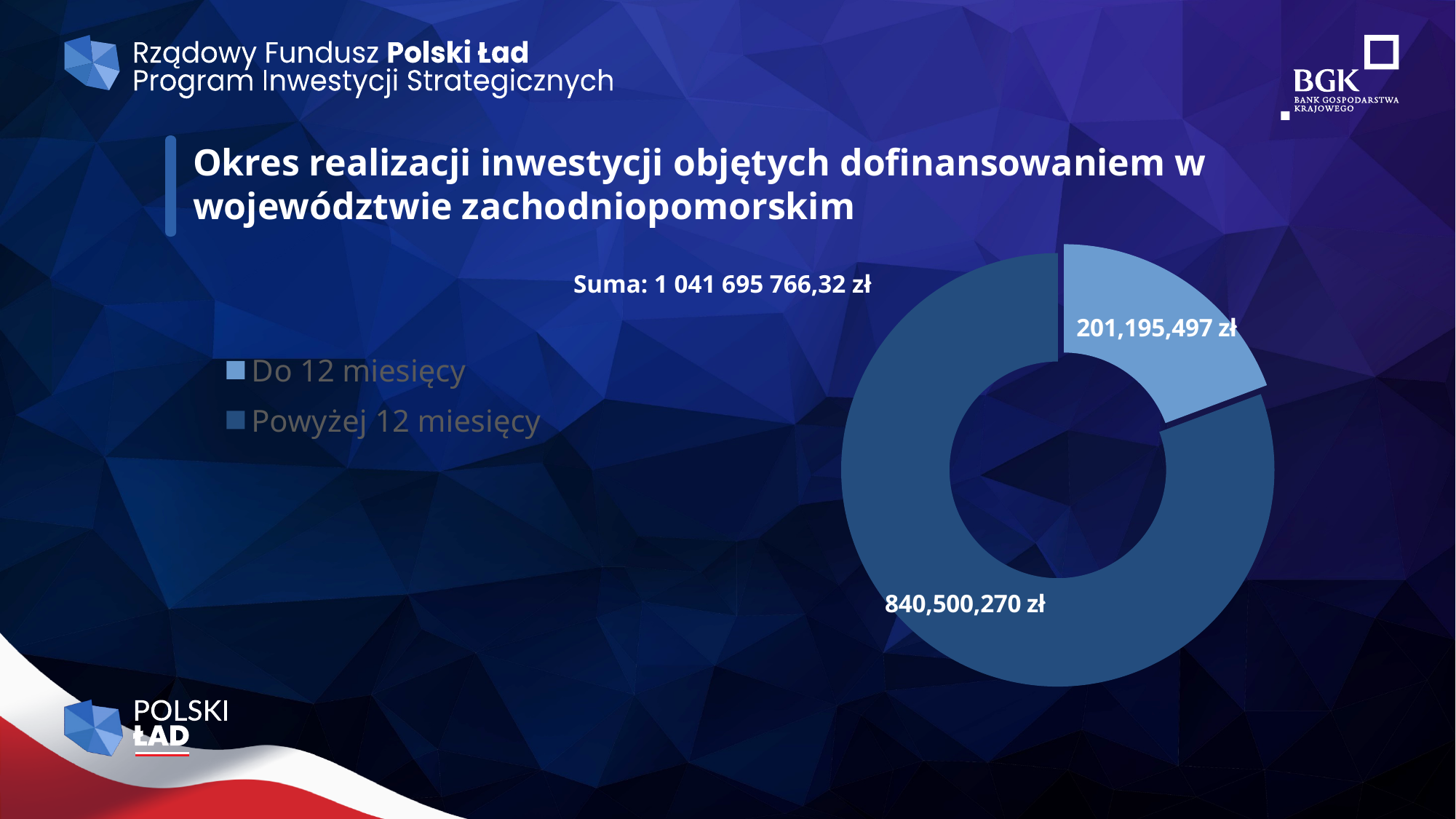
What is the difference between the value for "Powyżej 12 miesięcy" and the value for "Do 12 miesięcy"? 639,304,773 zł Which is larger: the value for "Do 12 miesięcy" or for "Powyżej 12 miesięcy"? Powyżej 12 miesięcy Which category has the largest value? Powyżej 12 miesięcy How many entries does the legend list? 2 What is the title of the slide containing the chart? Okres realizacji inwestycji objętych dofinansowaniem w województwie zachodniopomorskim What kind of chart is shown on the slide? Doughnut (pie) chart Which category has the smallest value? Do 12 miesięcy Which legend entry is shown in the lighter blue colour? Do 12 miesięcy What total sum (Suma) is printed on the slide for the chart? 1 041 695 766,32 zł What is the value for "Do 12 miesięcy"? 201,195,497 zł What is the value for "Powyżej 12 miesięcy"? 840,500,270 zł How many categories does the chart show? 2